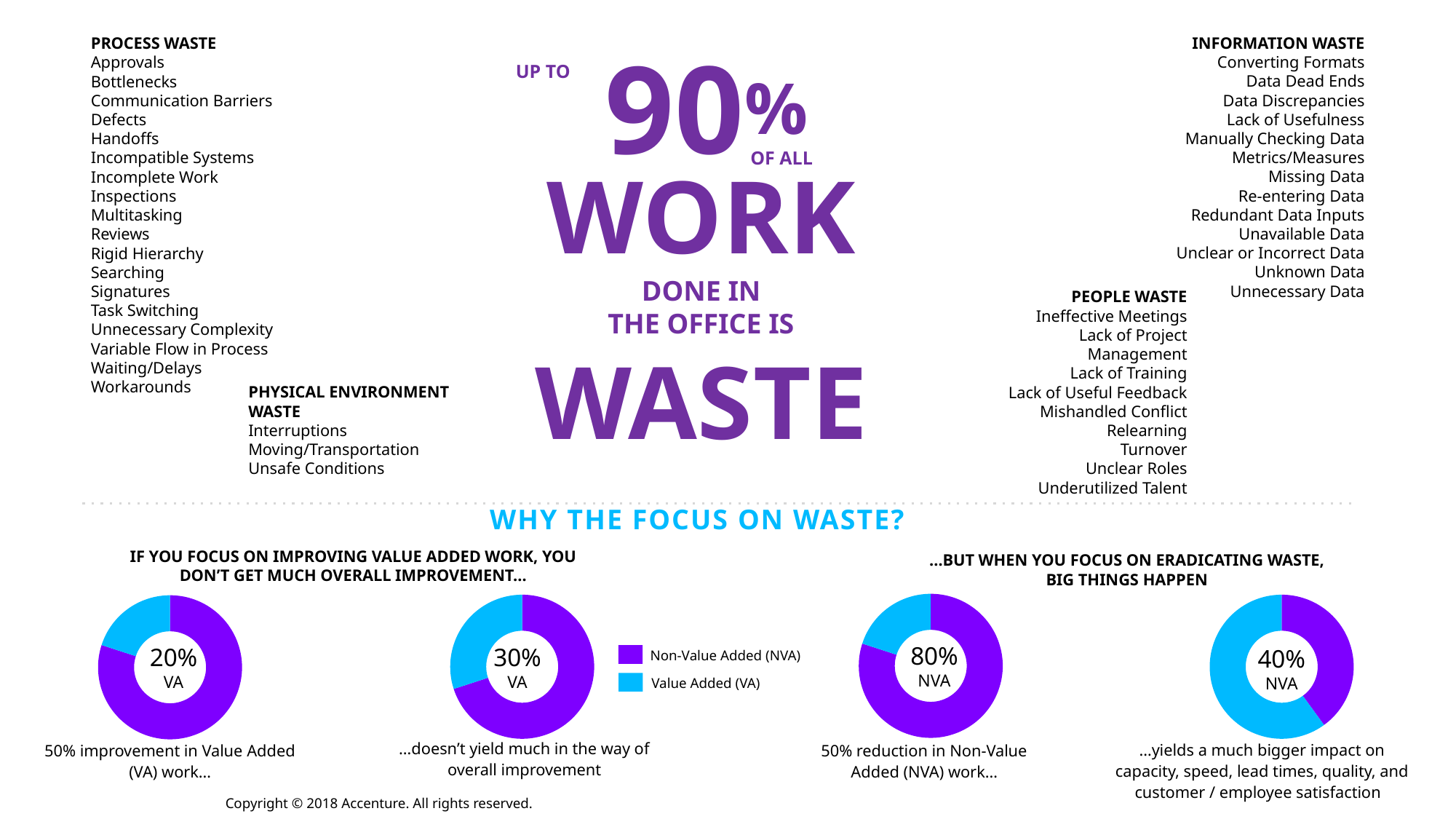
In the rightmost donut chart, which segment is larger, Non-Value Added (NVA) or Value Added (VA)? Value Added (VA) In the leftmost donut chart, what percentage is labelled as Value Added (VA)? 20% In the rightmost donut chart, what percentage is labelled as Non-Value Added (NVA)? 40% In the third donut chart from the left, what percentage is labelled as Non-Value Added (NVA)? 80% In the second donut chart from the left, what percentage is labelled as Value Added (VA)? 30% What is the difference in percentage points between the VA value in the second donut chart (30%) and the VA value in the leftmost donut chart (20%)? 10 percentage points What is the difference in percentage points between the NVA value in the third donut chart (80%) and the NVA value in the rightmost donut chart (40%)? 40 percentage points What kind of chart is used in the bottom section of the slide? Donut (pie) chart According to the legend, which colour represents Value Added (VA)? Blue How many entries does the legend next to the second donut chart list? 2 How many donut charts are shown on the slide? 4 In the leftmost donut chart, which segment is larger, Non-Value Added (NVA) or Value Added (VA)? Non-Value Added (NVA)